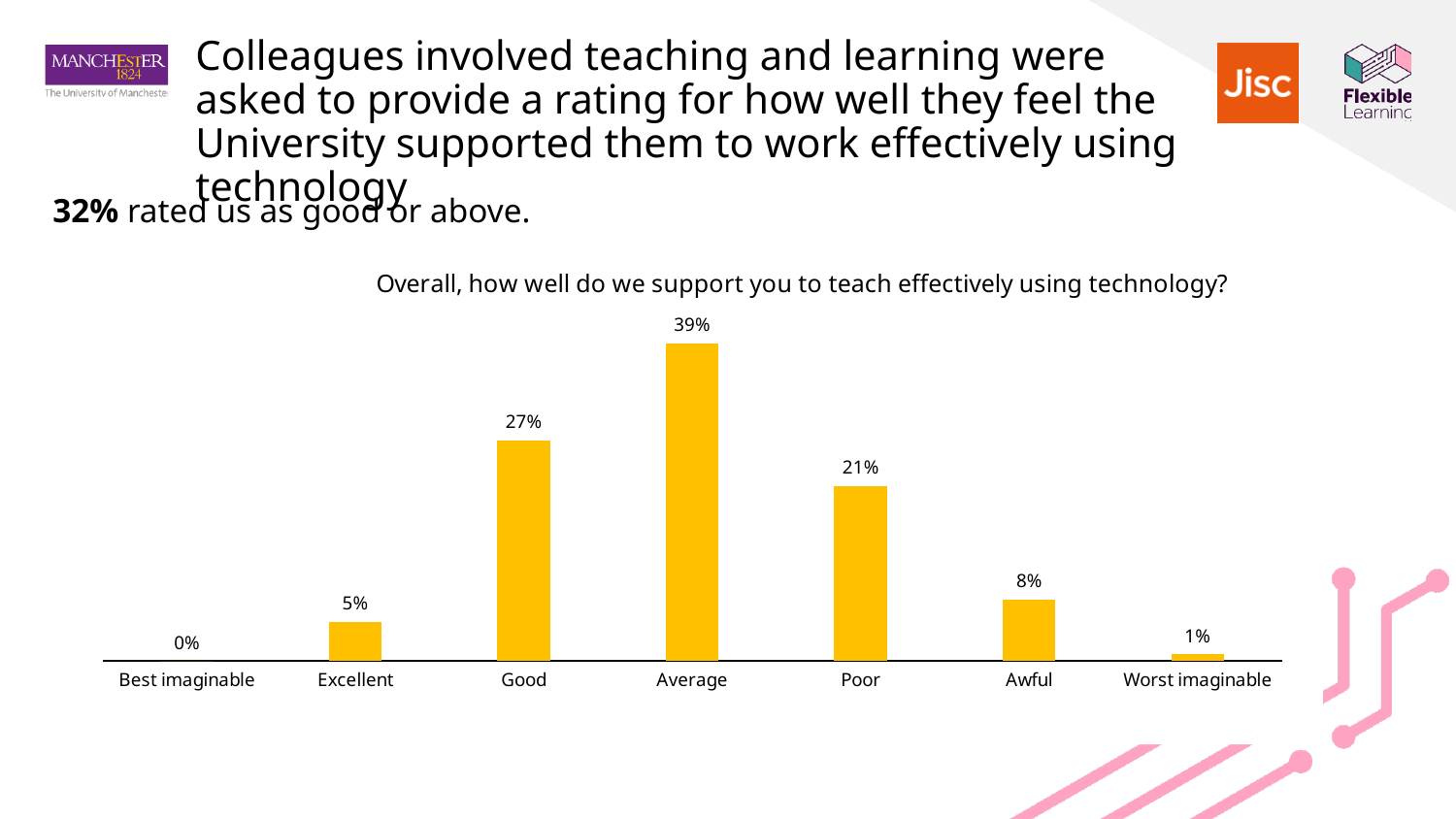
What percentage of respondents rated support as Average? 39% Which rating category has the highest percentage? Average What percentage of respondents rated support as Best imaginable? 0% What is the title of the chart? Overall, how well do we support you to teach effectively using technology? What percentage of respondents rated support as Poor? 21% What is the difference between the percentages for Average and Good? 12% How many rating categories are shown on the x axis? 7 Which is larger, the percentage for Excellent or the percentage for Awful? Awful What percentage of respondents rated support as Good? 27% What kind of chart is shown on the slide? Bar chart What is the difference between the percentages for Poor and Awful? 13% Which rating category has the lowest percentage? Best imaginable